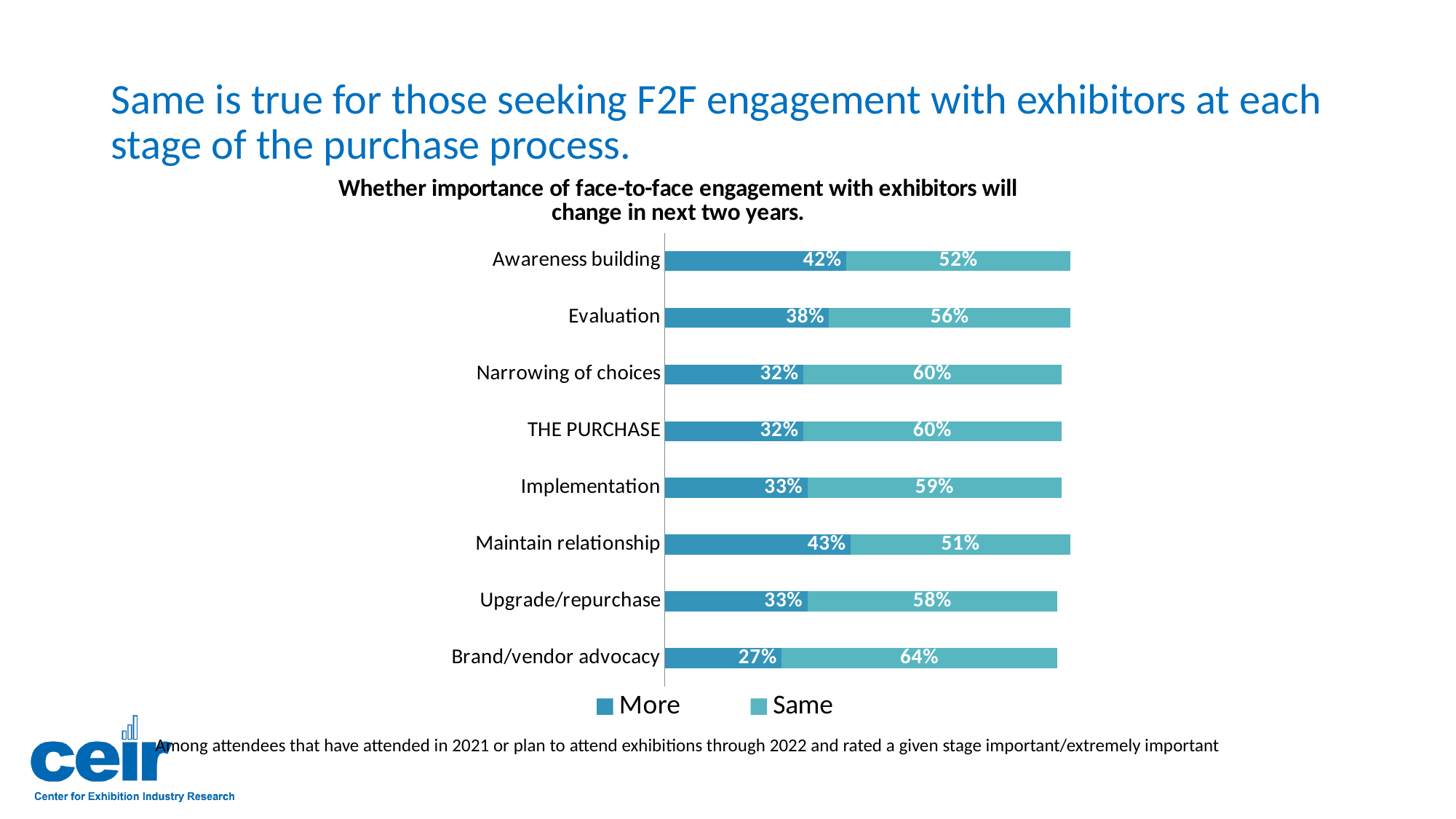
What is the "Same" value for Evaluation? 56% How many series does the legend list? 2 How many categories are shown in the chart? 8 What is the title of the chart? Whether importance of face-to-face engagement with exhibitors will change in next two years. What is the "Same" value for Brand/vendor advocacy? 64% What kind of chart is shown on the slide? Stacked bar chart Which is larger, the "More" value for Evaluation or the "More" value for Upgrade/repurchase? Evaluation What is the difference between the "Same" and "More" values for Implementation? 26% What is the "More" value for Awareness building? 42% Which category has the lowest "More" value? Brand/vendor advocacy Which category has the highest "More" value? Maintain relationship What is the total of the "More" and "Same" values for Maintain relationship? 94%